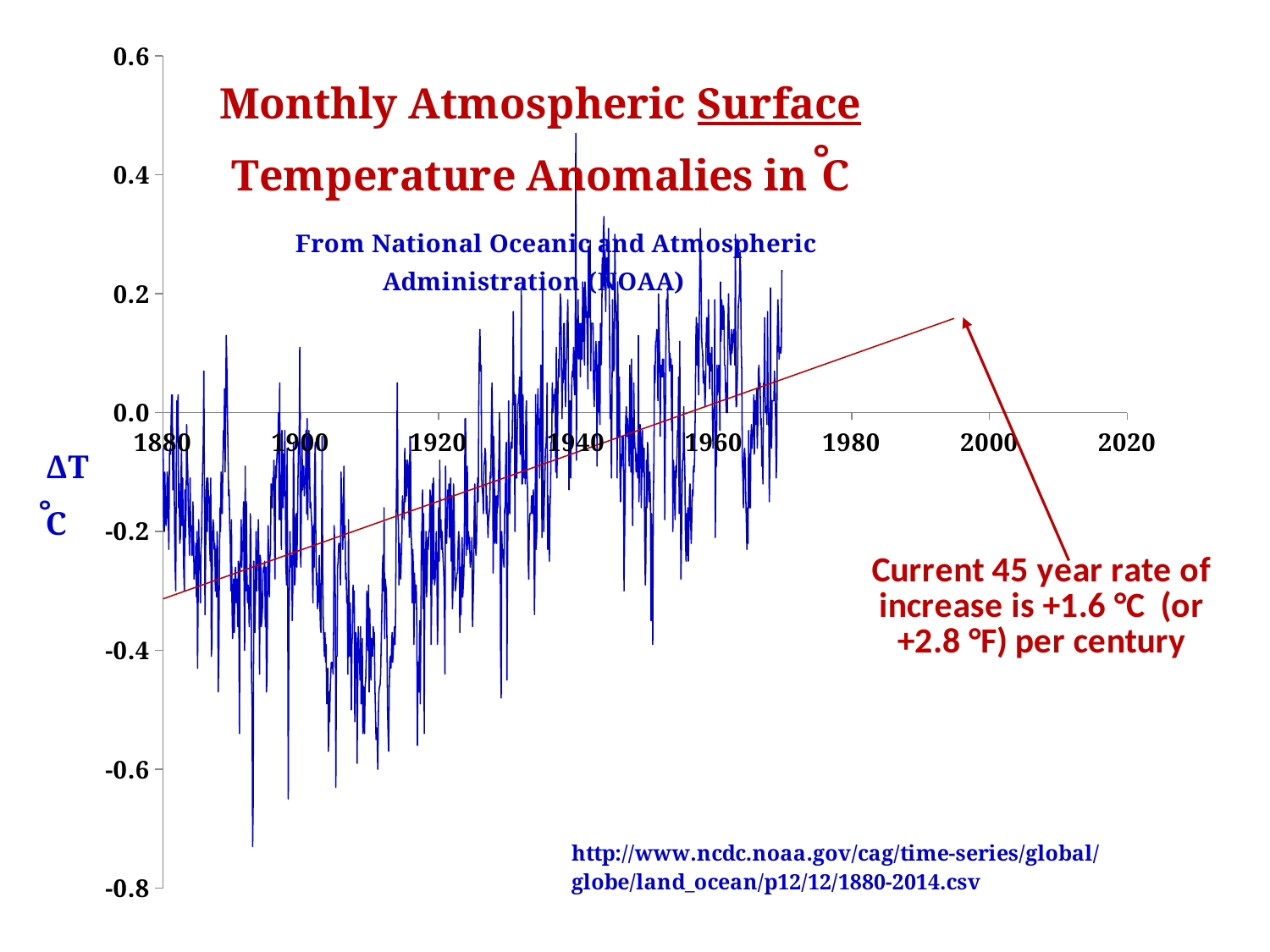
What is the title of the chart? Monthly Atmospheric Surface Temperature Anomalies in °C Is the highest plotted temperature anomaly greater or less than 0.4? greater According to the annotation, what is the current 45 year rate of increase in °C per century? +1.6 °C What kind of chart is shown on the slide? line chart What is the lowest value shown on the vertical axis? -0.8 Is the value of the red trend line at 1900 greater or less than 0.0? less What is the first year labelled on the horizontal axis? 1880 What is the highest value shown on the vertical axis? 0.6 Is the highest plotted temperature anomaly greater or less than 0.6? less Overall, do the temperature anomalies rise or fall from 1880 toward the end of the plotted data? rise Are the temperature anomalies around 1940 higher or lower than those around 1890? higher